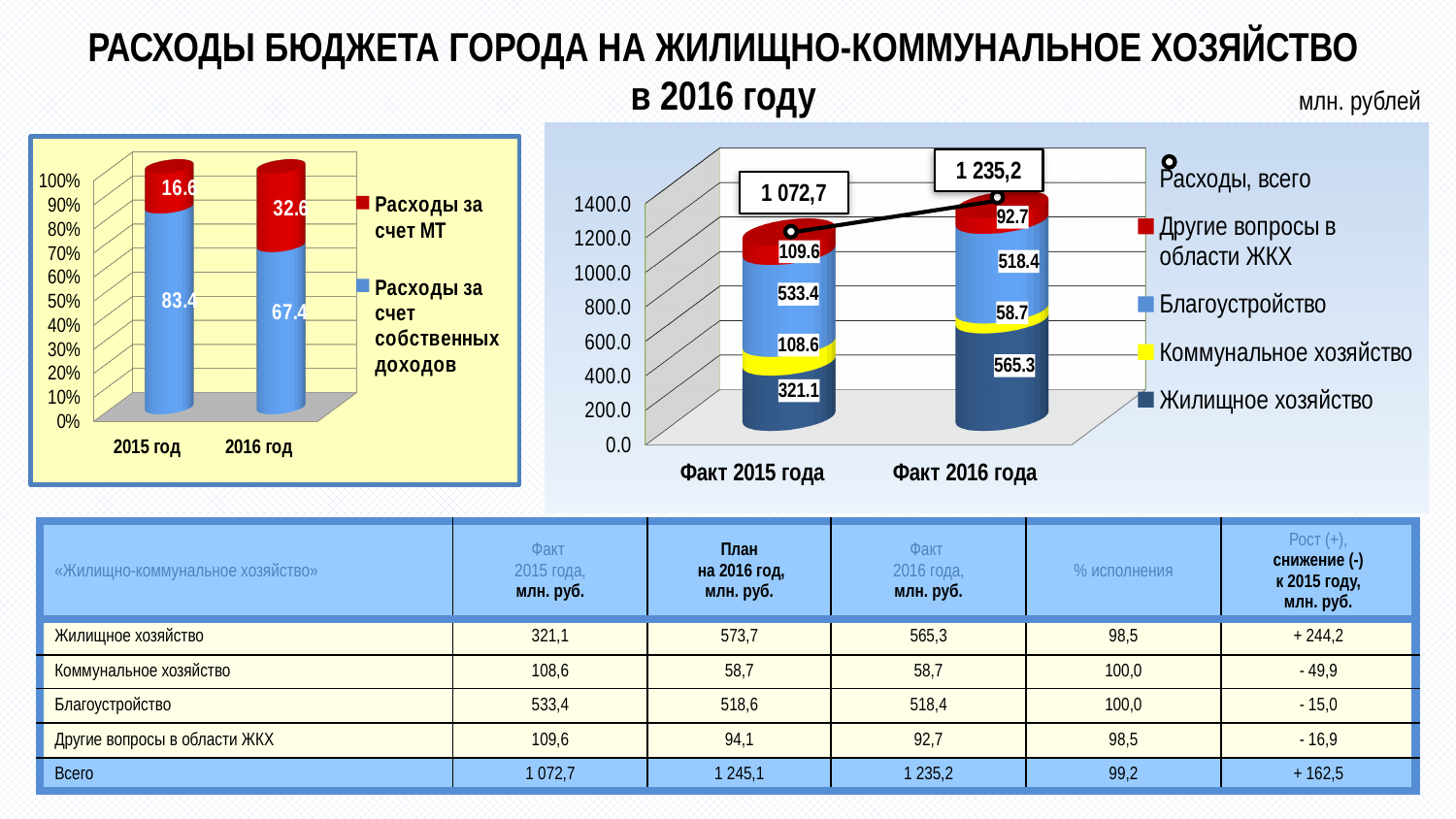
In the left chart, what is the value for Расходы за счет собственных доходов for 2015 год? 83,4 What kind of chart is the left chart? stacked bar chart In the left chart, does the share of Расходы за счет МТ rise or fall from 2015 год to 2016 год? rise In the left chart, what is the value for Расходы за счет МТ for 2016 год? 32,6 In the right chart, what is the total Расходы, всего for Факт 2016 года? 1 235,2 In the right chart, what is the value for Благоустройство for Факт 2015 года? 533,4 In the right chart, how many series does the legend list? 5 In the right chart, which series has the smallest value for Факт 2016 года? Коммунальное хозяйство In the right chart, which is larger: Коммунальное хозяйство for Факт 2015 года or for Факт 2016 года? Факт 2015 года In the right chart, what is the value for Жилищное хозяйство for Факт 2016 года? 565,3 In the right chart, what is the difference between Расходы, всего for Факт 2016 года and Факт 2015 года? 162,5 In the right chart, what is the difference between Жилищное хозяйство for Факт 2016 года and Факт 2015 года? 244,2